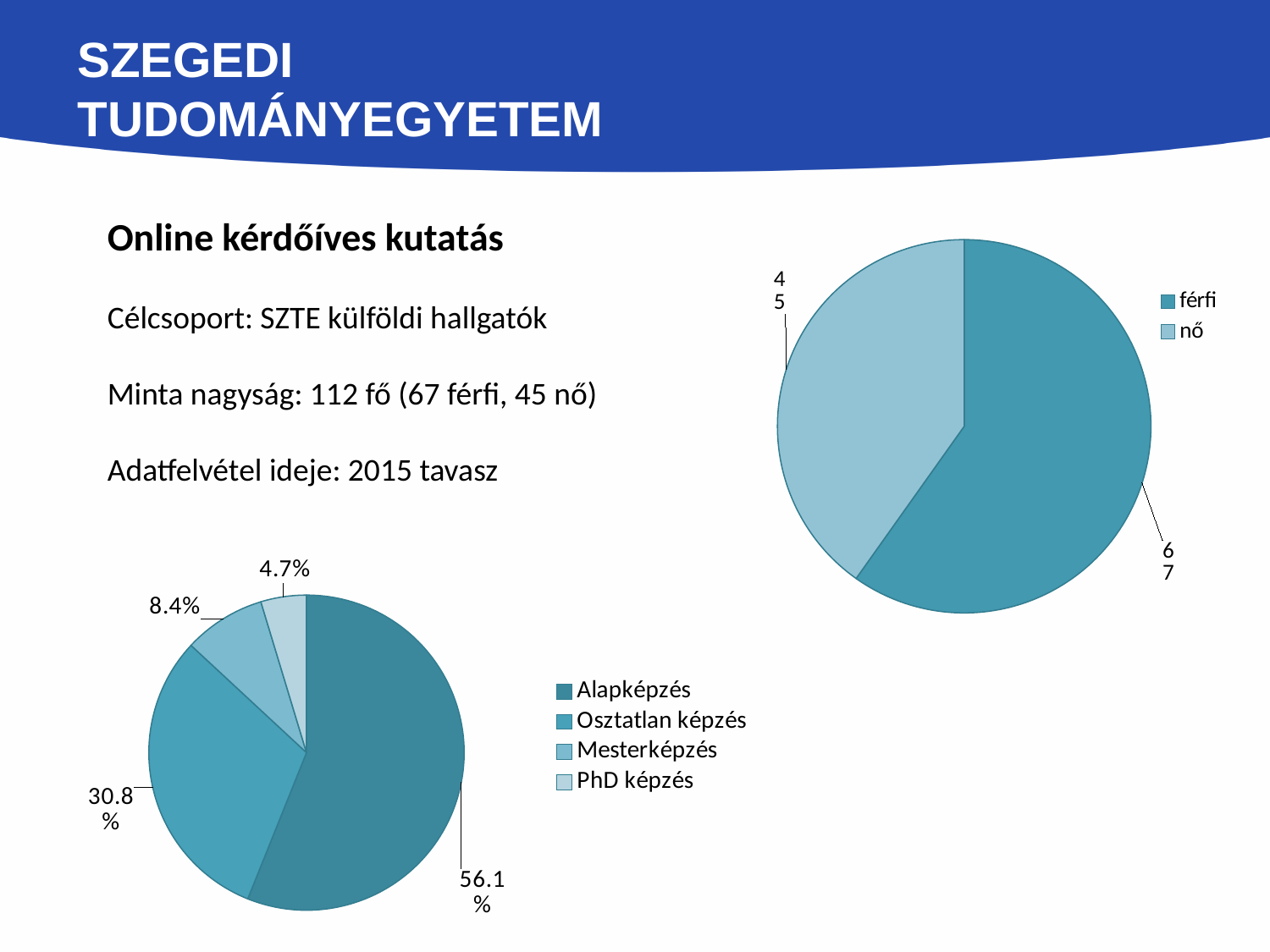
What kind of chart is the chart in the bottom left of the slide? pie chart In the pie chart in the bottom left, which category has the largest share? Alapképzés In the pie chart in the bottom left, which category has the smallest share? PhD képzés In the pie chart in the bottom left, what share does Osztatlan képzés have? 30.8% In the pie chart in the bottom left, what share does Alapképzés have? 56.1% In the gender pie chart on the right, which category has the larger value, férfi or nő? férfi How many categories does the legend of the pie chart in the bottom left list? 4 In the pie chart in the bottom left, what share does PhD képzés have? 4.7% In the gender pie chart on the right, what is the value for nő? 45 How many series does the legend of the gender pie chart on the right list? 2 In the gender pie chart on the right, what is the difference between the férfi and nő values? 22 In the gender pie chart on the right, what is the value for férfi? 67